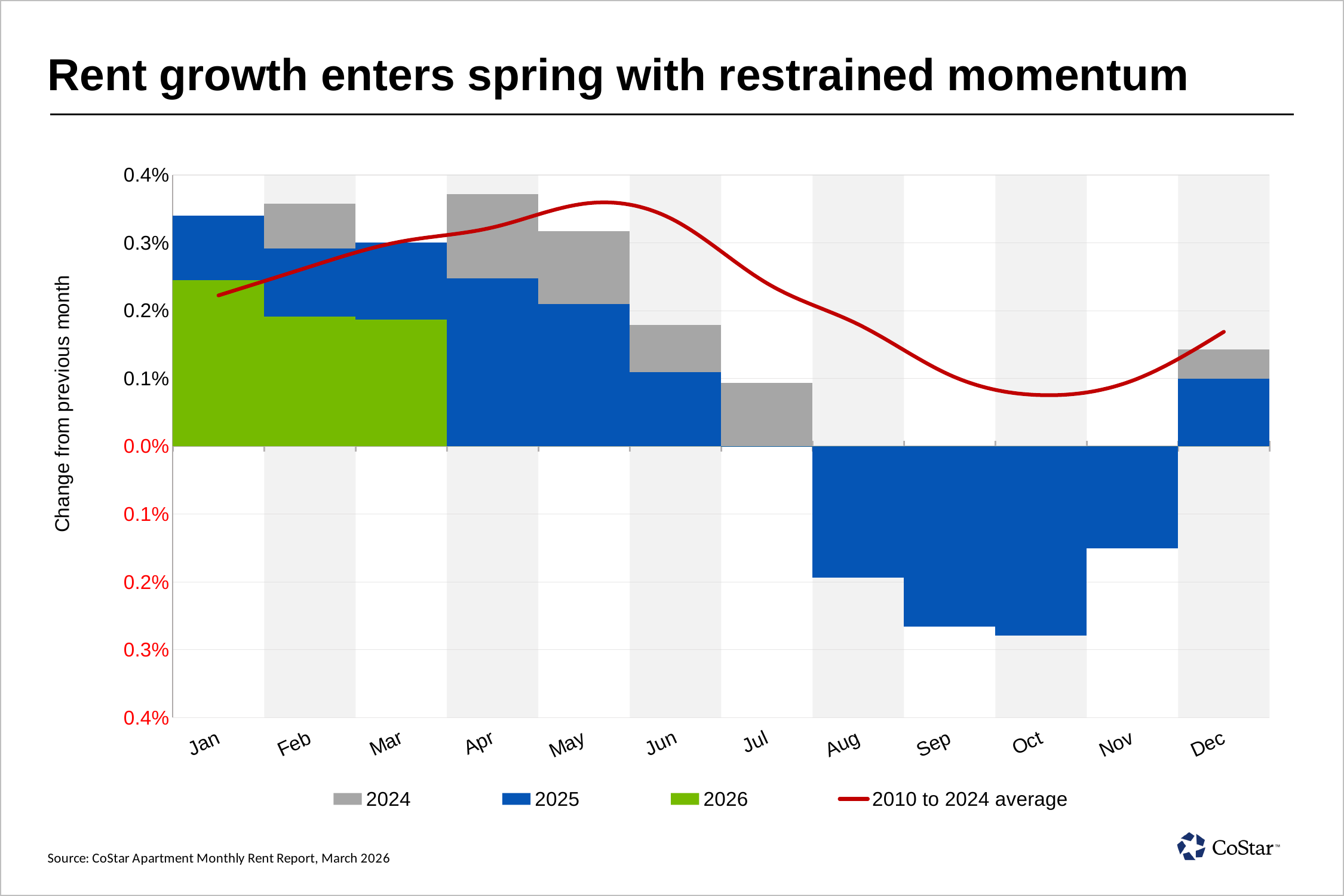
Is the 2026 value for Jan greater or less than 0.2%? greater How many series does the legend list? 4 Do the 2025 values rise or fall from Mar to Jun? fall Is the 2025 value for Oct greater or less than -0.2%? less What kind of chart is shown on the slide? Bar chart with a line Which is larger, the 2025 value for Jan or the 2025 value for Feb? Jan Which is larger for Apr, the 2024 value or the 2025 value? 2024 Is the 2024 value for Apr greater or less than 0.3%? greater How many months are shown on the x axis? 12 Which series is drawn as a red line? 2010 to 2024 average